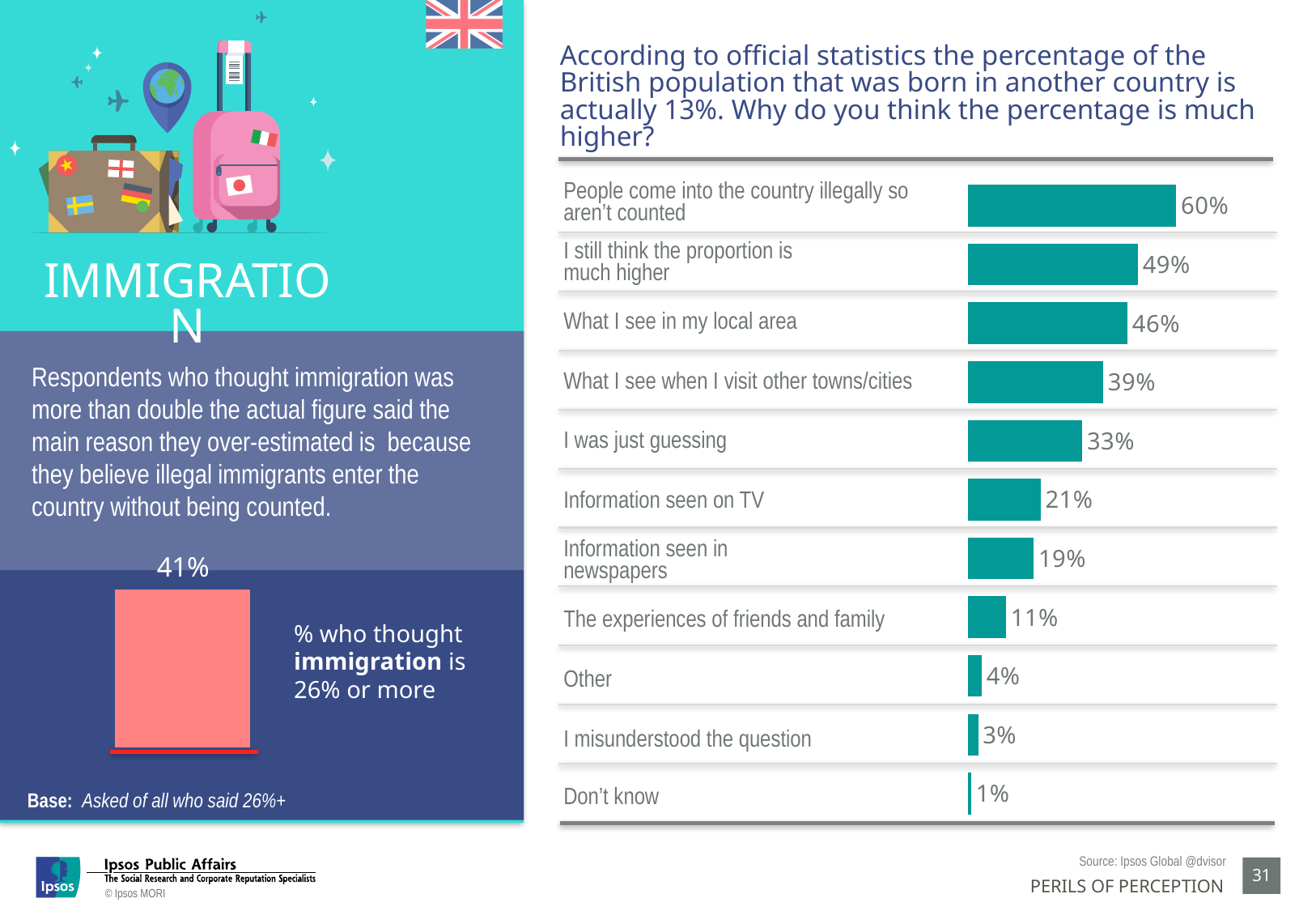
On the right-hand bar chart, which is larger: "Information seen on TV" or "The experiences of friends and family"? Information seen on TV On the right-hand bar chart, which reason has the lowest percentage? Don't know What colour are the bars on the right-hand bar chart? Teal On the left-hand chart, what percentage of respondents thought immigration is 26% or more? 41% On the right-hand bar chart, what percentage is shown for "I was just guessing"? 33% On the right-hand bar chart, what is the combined percentage for "Other" and "I misunderstood the question"? 7% On the right-hand bar chart, which reason has the highest percentage? People come into the country illegally so aren't counted On the right-hand bar chart, what percentage is shown for "People come into the country illegally so aren't counted"? 60% How many reasons (categories) are listed on the right-hand bar chart? 11 On the right-hand bar chart, what percentage is shown for "Information seen in newspapers"? 19% On the right-hand bar chart, what is the difference between "What I see in my local area" and "What I see when I visit other towns/cities"? 7% What kind of chart is shown on the right-hand side of the slide? Bar chart